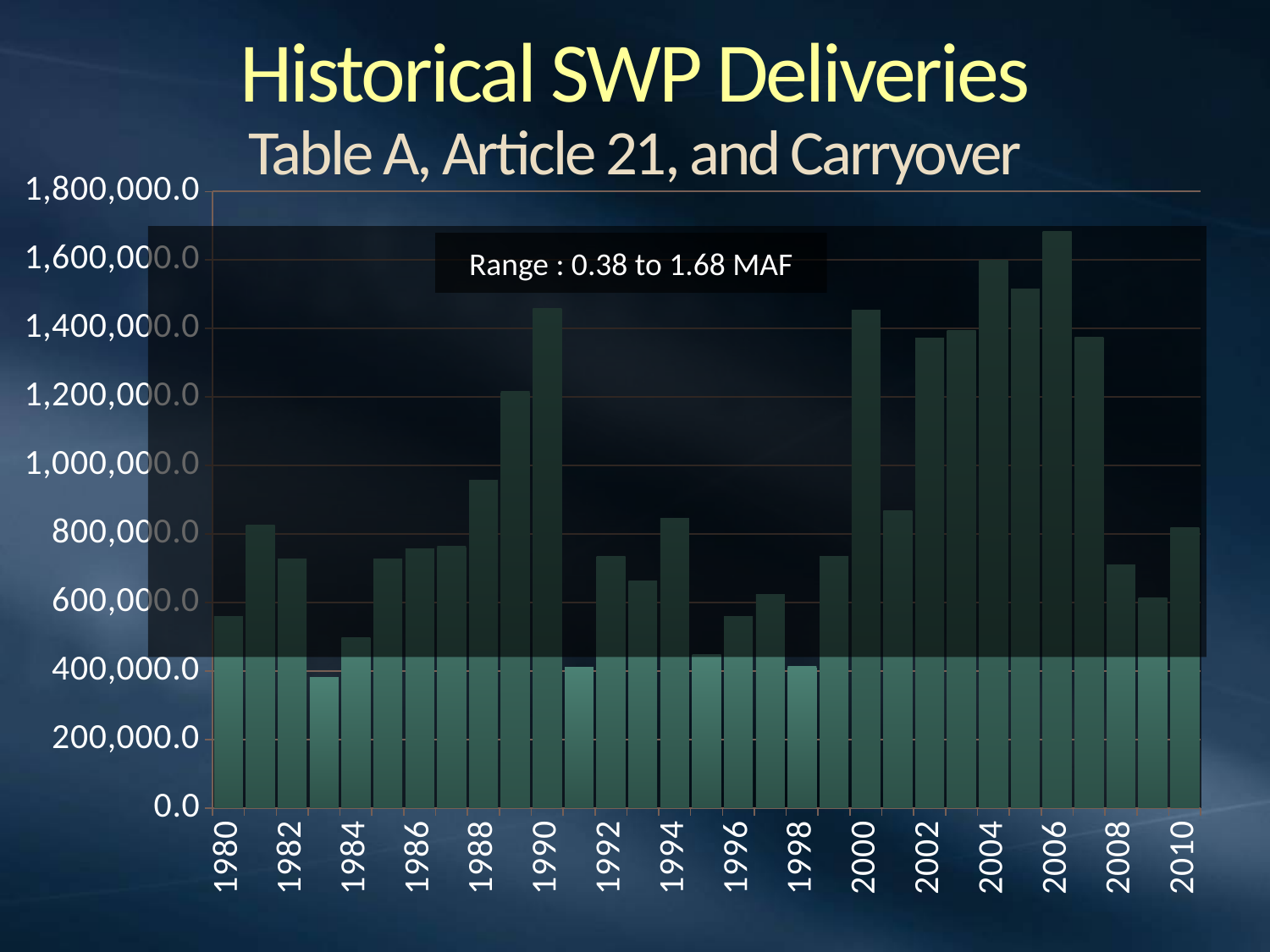
Is the value for 1996 greater or less than 600,000? less Which year has the larger value, 1983 or 1984? 1984 Which year has the lowest bar in the chart? 1983 What range of deliveries does the text box on the chart state? 0.38 to 1.68 MAF Which year has the highest bar in the chart? 2006 Is the value for 2005 greater or less than 1,400,000? greater Is the value for 1988 greater or less than 1,000,000? less What is the title of the chart on the slide? Historical SWP Deliveries What kind of chart is shown on the slide? Bar chart How many years (bars) are plotted in the chart? 31 Which year has the larger value, 1989 or 1990? 1990